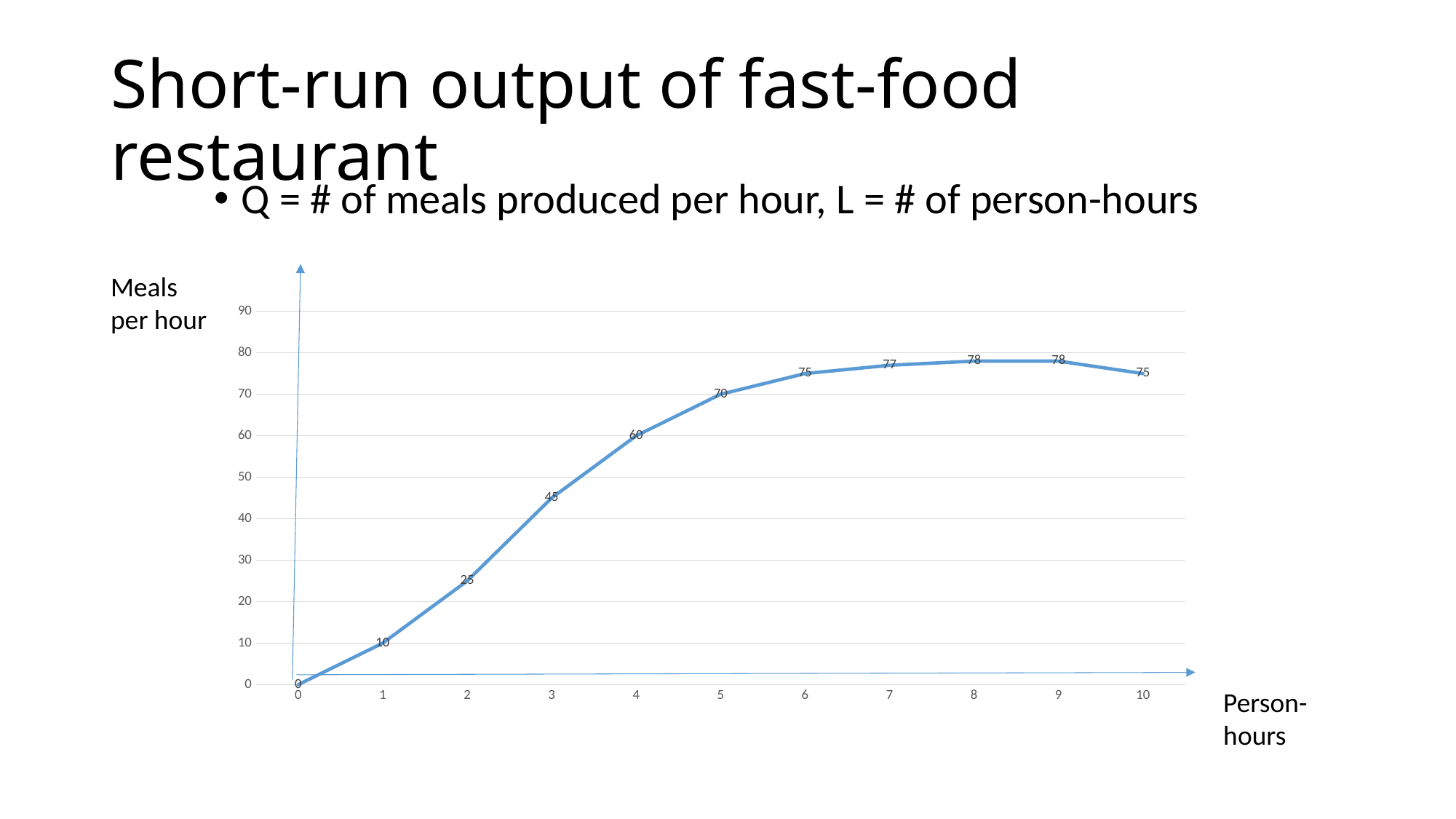
What is the value plotted at 1 person-hour? 10 What label is shown on the vertical axis of the chart? Meals per hour What is the value plotted at 5 person-hours? 70 What is the highest value plotted on the line? 78 What is the value plotted at 10 person-hours? 75 What type of chart is shown on the slide? line chart How many meals per hour are produced at 3 person-hours? 45 What is the difference between the values at 4 and 2 person-hours? 35 Does the line rise or fall between 0 and 8 person-hours? rise Which is larger, the value at 6 person-hours or the value at 10 person-hours? 6 person-hours At which person-hours value is the lowest output plotted? 0 How many data points are plotted on the line? 11